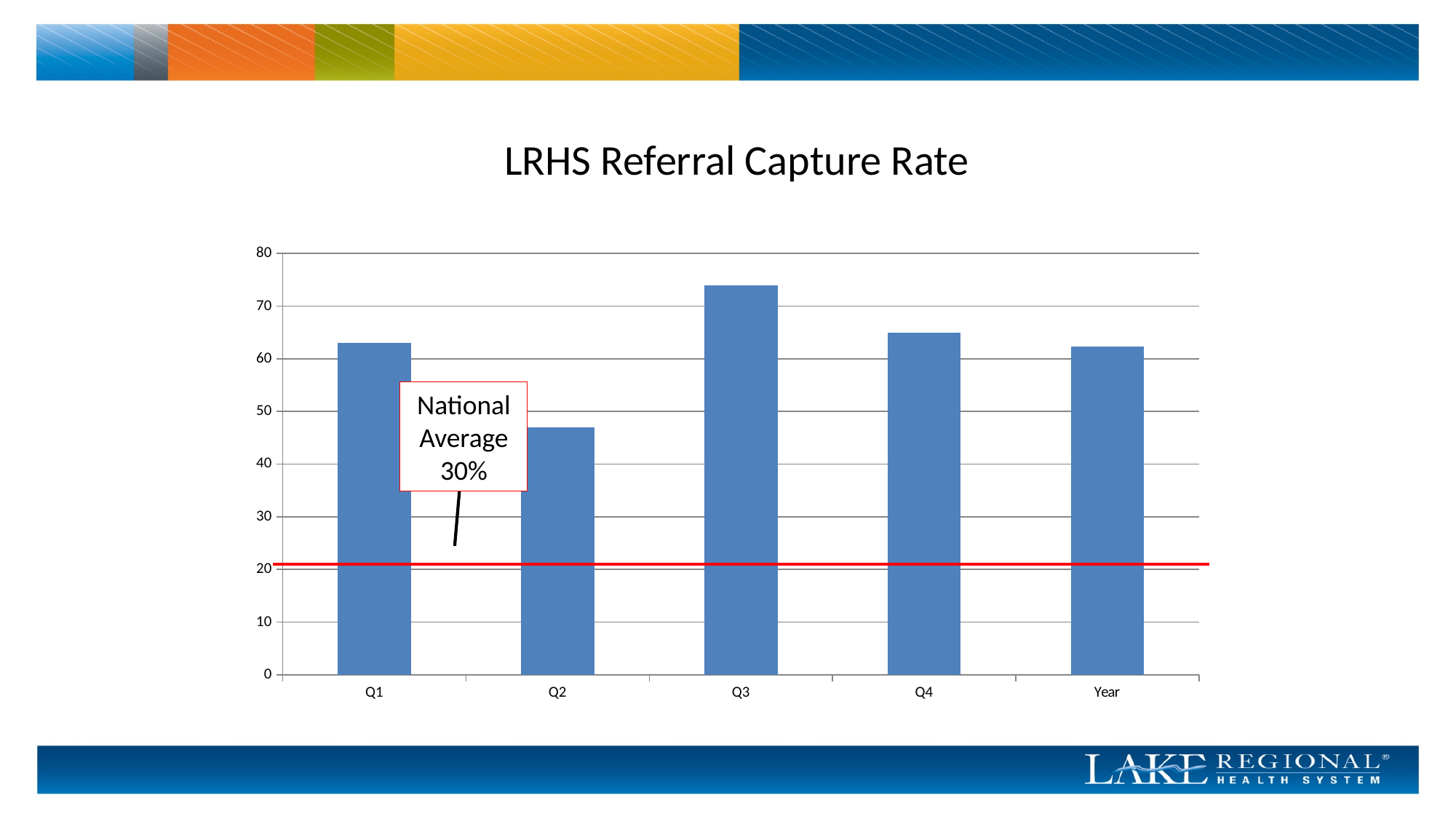
Is the value for Q3 greater or less than 70? greater What does the callout box on the chart say the National Average is? 30% What is the title of the chart? LRHS Referral Capture Rate Which is larger, the value for Q3 or the value for Q4? Q3 Which category has the highest bar in the chart? Q3 Which category has the lowest bar in the chart? Q2 What kind of chart is shown on the slide? bar chart How many categories are shown on the x axis of the chart? 5 Is the value for Q4 greater or less than 60? greater Is the value for Q2 greater or less than 50? less Which is larger, the value for Q1 or the value for Q2? Q1